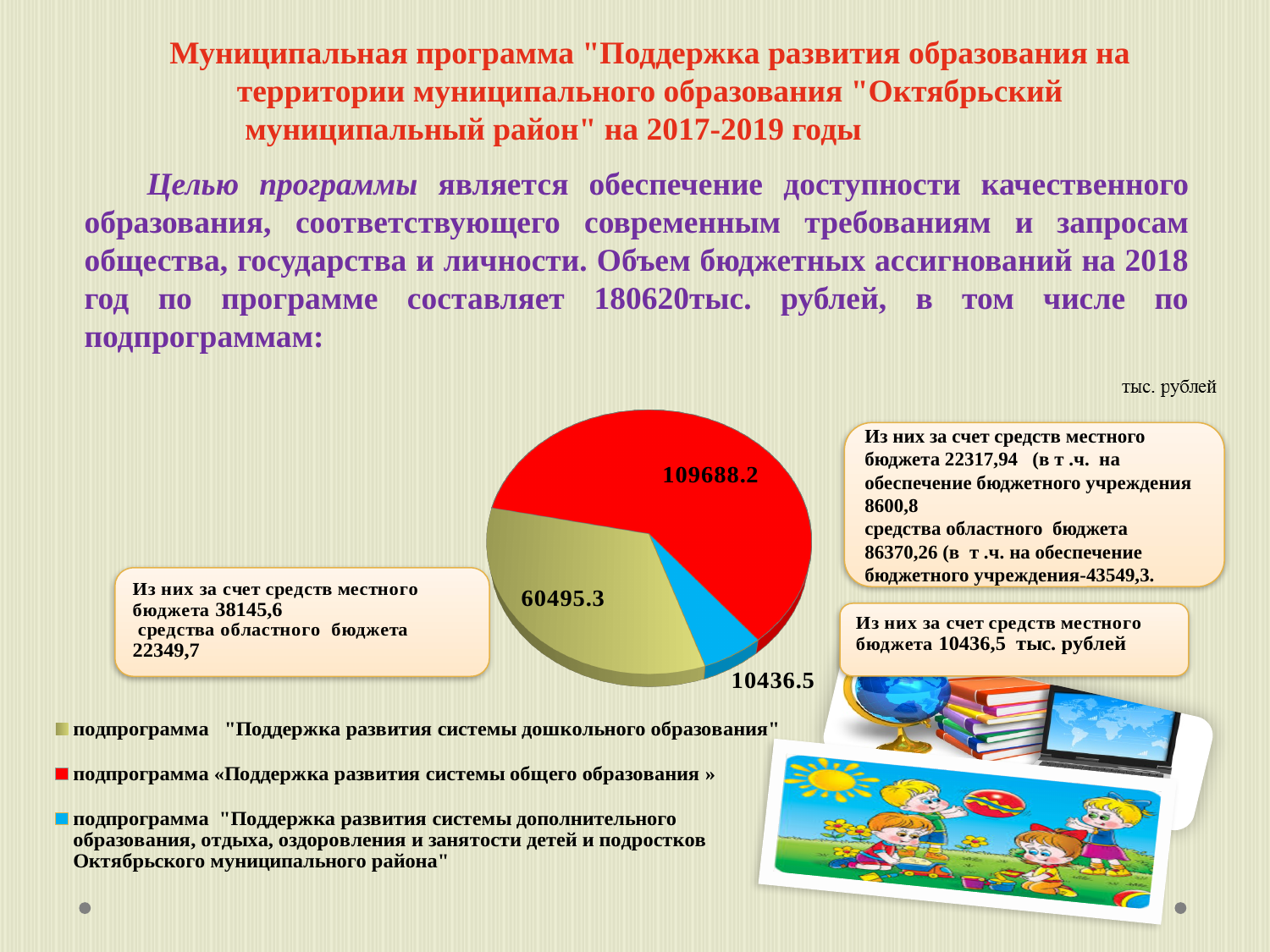
How many entries does the legend of the pie chart list? 3 Which subprogram has the smallest slice in the pie chart? подпрограмма "Поддержка развития системы дополнительного образования, отдыха, оздоровления и занятости детей и подростков Октябрьского муниципального района" What is the value of the slice for the subprogram "Поддержка развития системы дополнительного образования, отдыха, оздоровления и занятости детей и подростков Октябрьского муниципального района"? 10436.5 What kind of chart is shown on the slide? pie chart How many slices does the pie chart have? 3 What is the value of the slice for the subprogram «Поддержка развития системы общего образования»? 109688.2 What is the value of the slice for the subprogram "Поддержка развития системы дошкольного образования"? 60495.3 Which is larger: the slice for дошкольного образования or the slice for дополнительного образования? дошкольного образования Which subprogram has the largest slice in the pie chart? подпрограмма «Поддержка развития системы общего образования» What is the difference between the values for общего образования and дошкольного образования? 49192.9 What is the difference between the values for дошкольного образования and дополнительного образования? 50058.8 What colour is the slice for the subprogram «Поддержка развития системы общего образования»? red